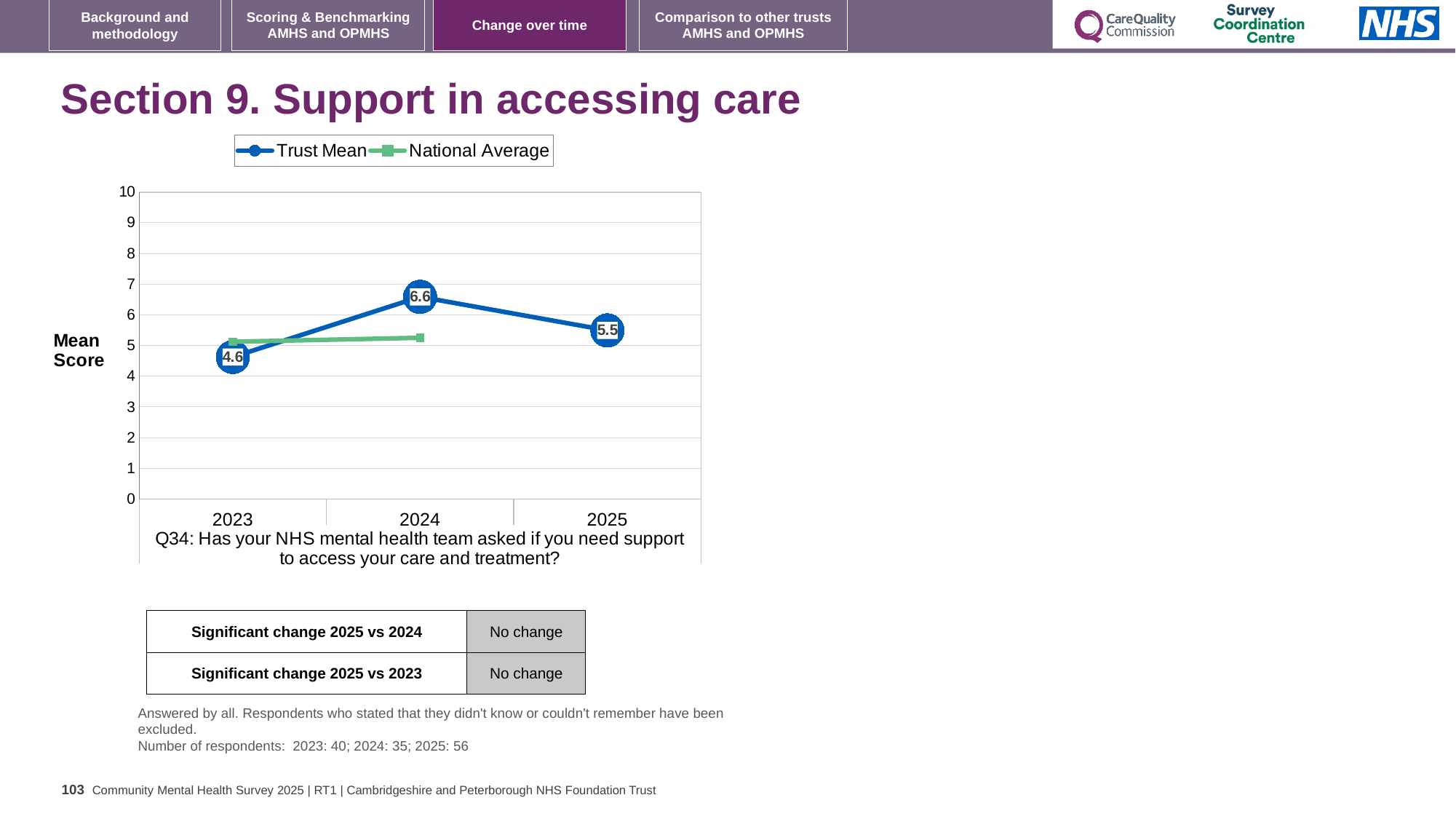
Is the National Average value for 2023 greater or less than 4? greater What is the Trust Mean score for 2025? 5.5 What is the difference between the Trust Mean in 2024 and in 2025? 1.1 How many years are shown on the x axis of the chart? 3 In which year is the Trust Mean highest? 2024 What is the Trust Mean score for 2023? 4.6 How many series does the legend list? 2 In which year is the Trust Mean lowest? 2023 Which is larger, the Trust Mean in 2025 or the Trust Mean in 2023? 2025 What is the difference between the Trust Mean in 2024 and in 2023? 2.0 What kind of chart is shown on the slide? Line chart What is the Trust Mean score for 2024? 6.6